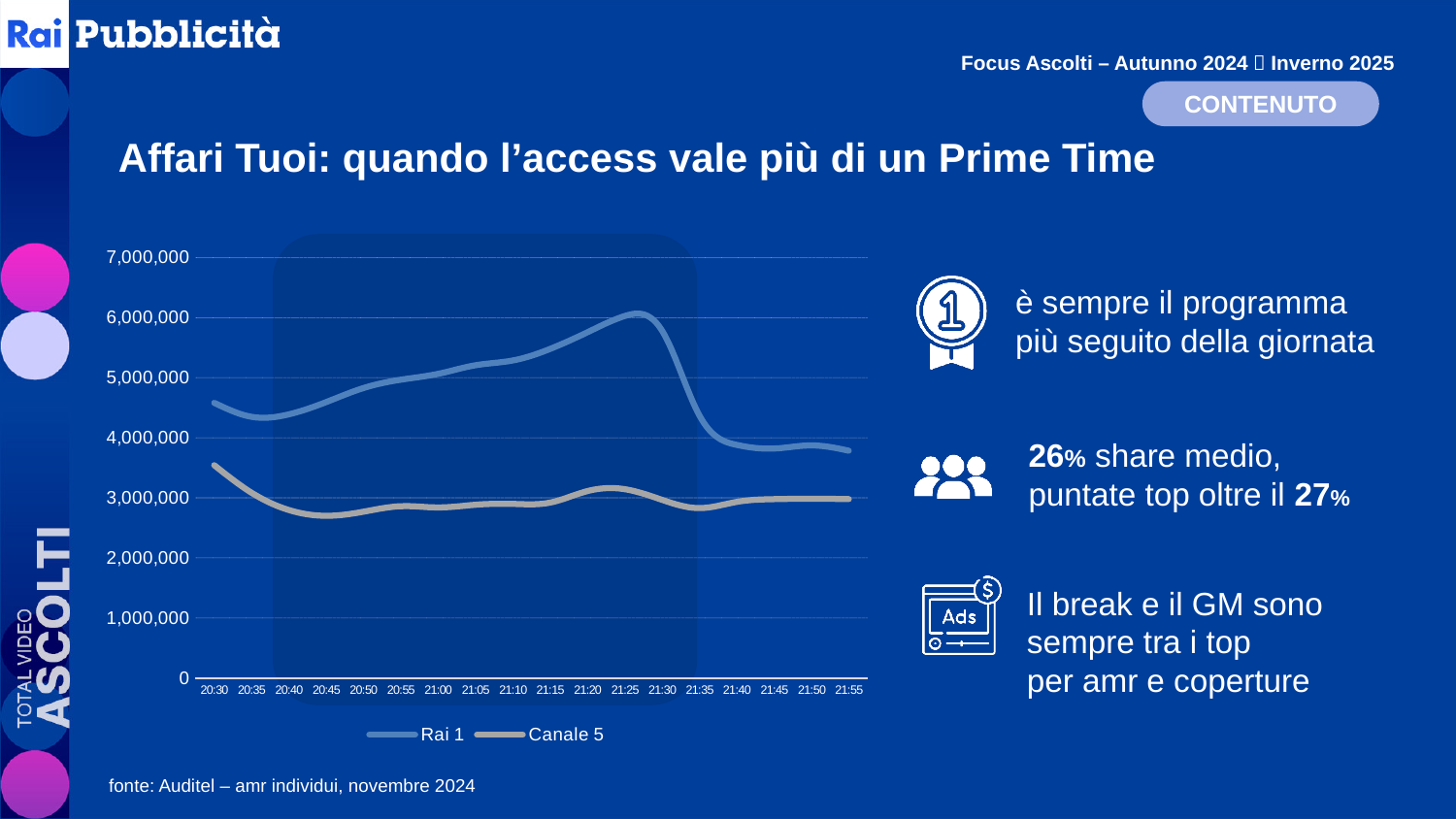
Does the Rai 1 line rise or fall between 21:25 and 21:35? fall Is the value for Canale 5 at 20:30 greater or less than 3,000,000? greater Is the value for Rai 1 at 21:25 greater or less than 5,000,000? greater At which time does the Rai 1 line reach its highest value? 21:25 How many series does the chart legend list? 2 What is the source cited below the chart? Auditel – amr individui, novembre 2024 Is the value for Canale 5 at 20:45 greater or less than 3,000,000? less How many time points are shown on the x axis of the chart? 18 Which two series are listed in the chart legend? Rai 1 and Canale 5 At 21:25, which series has the larger value, Rai 1 or Canale 5? Rai 1 What kind of chart is shown on the slide? line chart